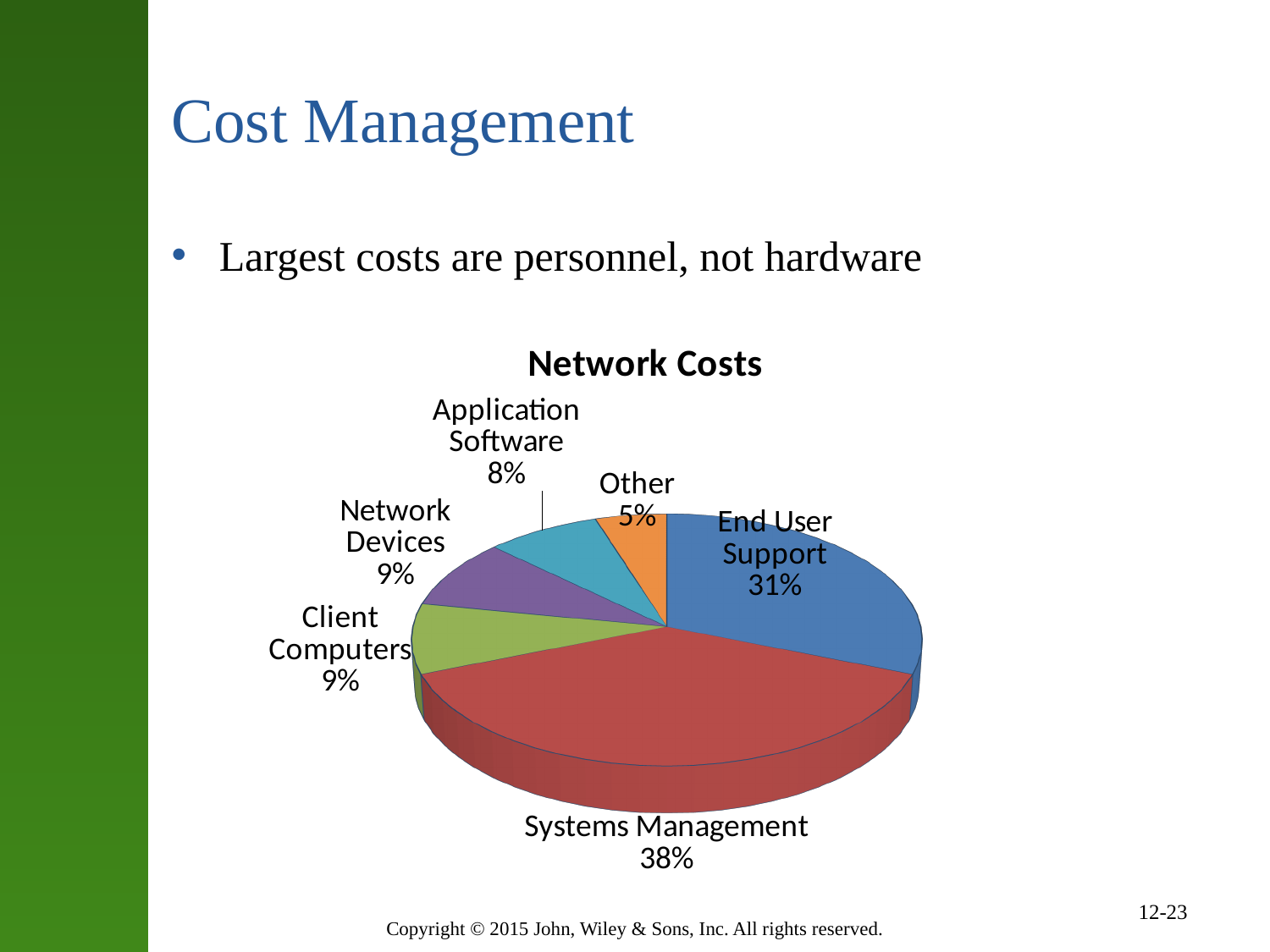
Which category has the smallest share of network costs? Other Which is larger, the share for Network Devices or the share for Application Software? Network Devices What kind of chart is shown on the slide? pie chart What share of network costs is Systems Management? 38% How many categories are shown in the pie chart? 6 Which category has the largest share of network costs? Systems Management What is the combined share of Systems Management and End User Support? 69% What share of network costs is End User Support? 31% What is the title of the chart? Network Costs What share of network costs is Other? 5% What share of network costs is Application Software? 8% What is the difference between the Systems Management share and the End User Support share? 7%